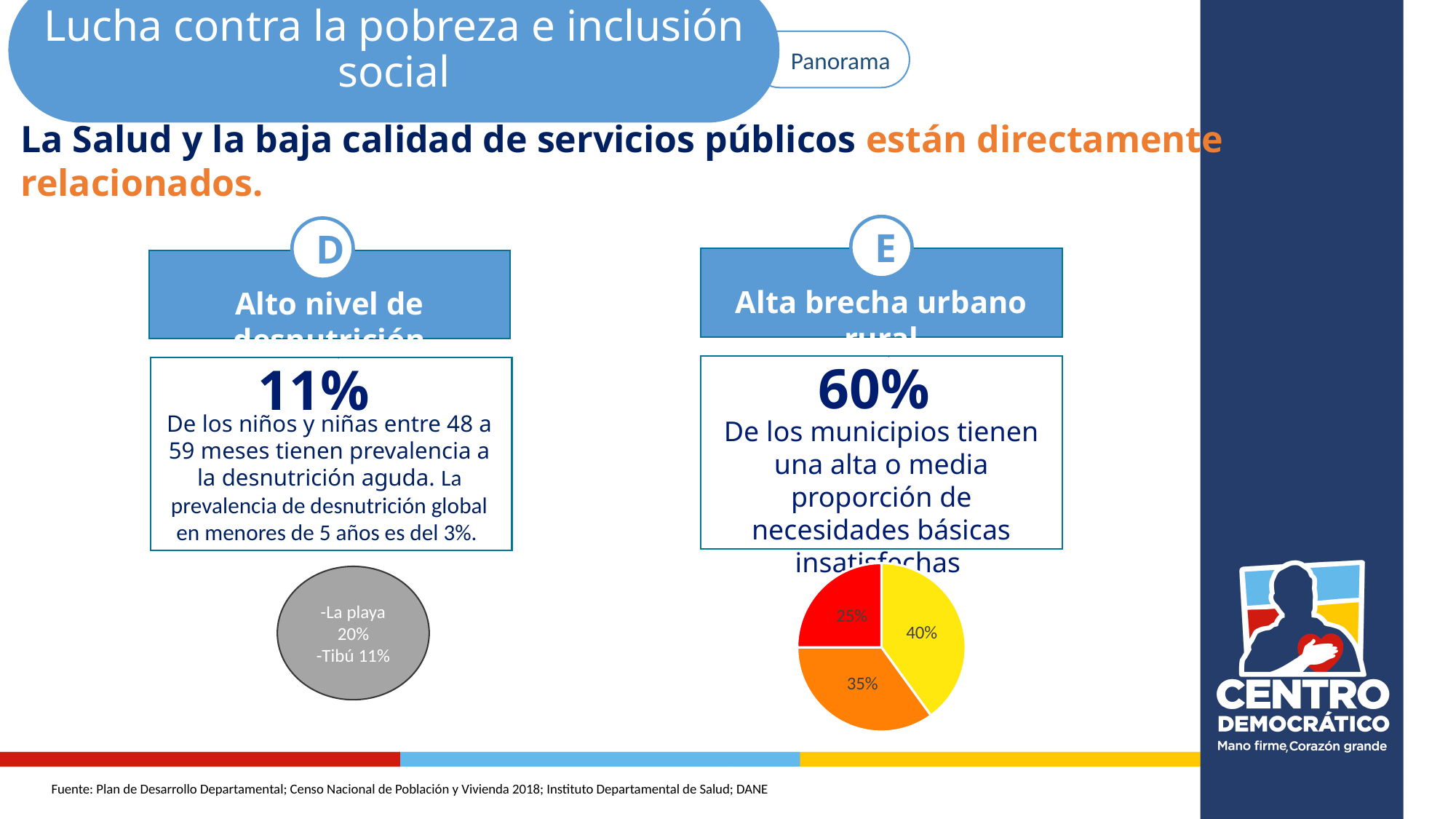
In the pie chart, what is the difference between the yellow slice and the orange slice? 5% What is the value of the orange slice in the pie chart? 35% How many slices does the pie chart on the slide have? 3 Which colour slice is the smallest in the pie chart? red Does the pie chart on the slide have a legend? No What kind of chart is shown at the bottom right of the slide, under the 'Alta brecha urbano rural' box? pie chart In the pie chart, which is larger, the orange slice or the red slice? orange What is the value of the yellow slice in the pie chart? 40% Which colour slice is the largest in the pie chart? yellow In the pie chart, what is the difference between the yellow slice and the red slice? 15% What is the value of the red slice in the pie chart? 25% What is the combined share of the orange and red slices in the pie chart? 60%